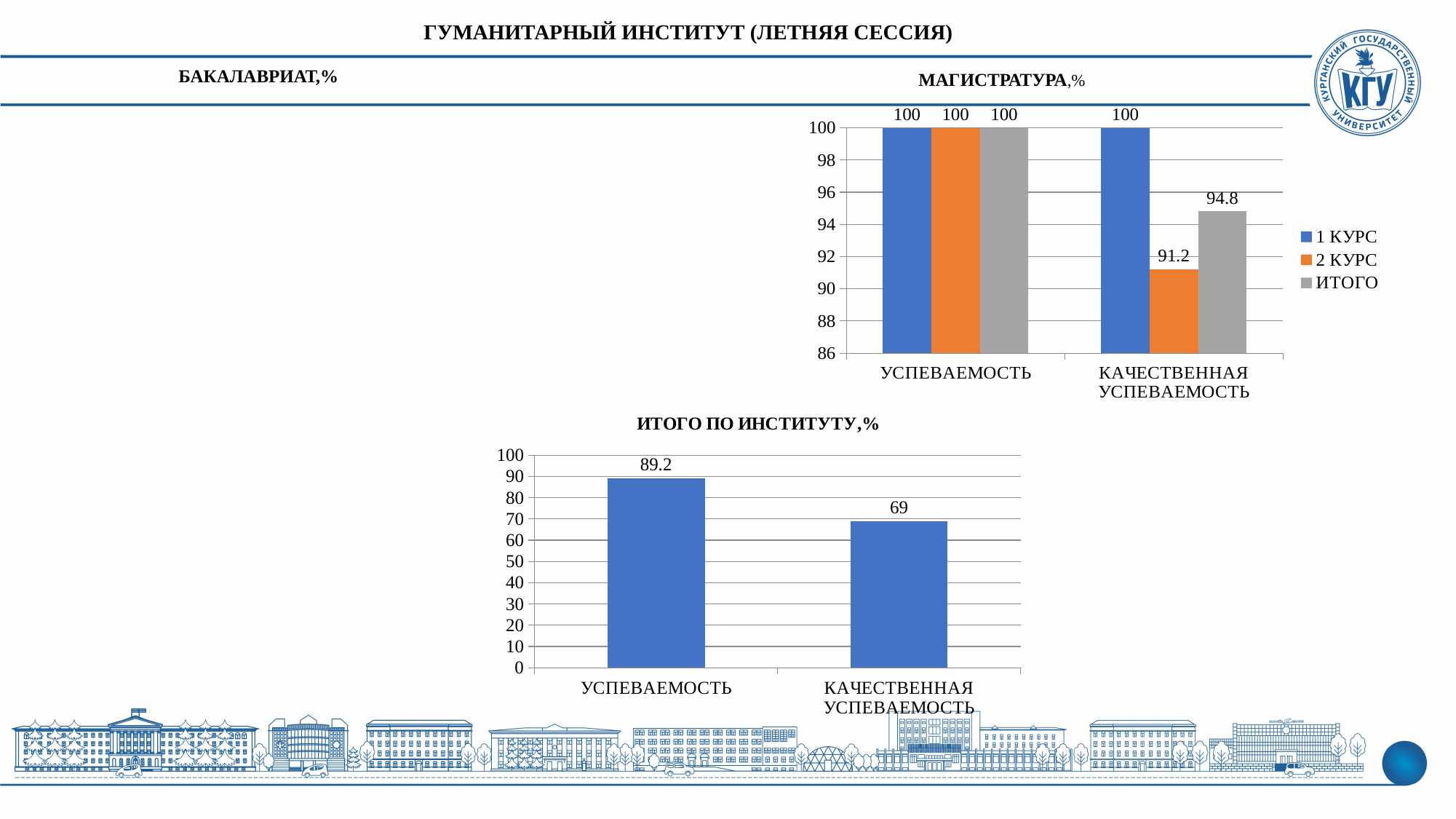
In the ИТОГО ПО ИНСТИТУТУ,% chart, what is the value for КАЧЕСТВЕННАЯ УСПЕВАЕМОСТЬ? 69 In the МАГИСТРАТУРА,% chart, how many series does the legend list? 3 In the МАГИСТРАТУРА,% chart, what is the value of ИТОГО for КАЧЕСТВЕННАЯ УСПЕВАЕМОСТЬ? 94.8 What kind of chart is the ИТОГО ПО ИНСТИТУТУ,% chart? Bar chart In the МАГИСТРАТУРА,% chart, what is the value of 1 КУРС for УСПЕВАЕМОСТЬ? 100 In the МАГИСТРАТУРА,% chart, which series has the lowest value for КАЧЕСТВЕННАЯ УСПЕВАЕМОСТЬ? 2 КУРС In the ИТОГО ПО ИНСТИТУТУ,% chart, which category has the higher value? УСПЕВАЕМОСТЬ In the МАГИСТРАТУРА,% chart, which colour represents the ИТОГО series? Grey In the МАГИСТРАТУРА,% chart, what is the value of 2 КУРС for КАЧЕСТВЕННАЯ УСПЕВАЕМОСТЬ? 91.2 In the МАГИСТРАТУРА,% chart, what is the difference between the ИТОГО and 2 КУРС values for КАЧЕСТВЕННАЯ УСПЕВАЕМОСТЬ? 3.6 In the ИТОГО ПО ИНСТИТУТУ,% chart, what is the difference between УСПЕВАЕМОСТЬ and КАЧЕСТВЕННАЯ УСПЕВАЕМОСТЬ? 20.2 In the ИТОГО ПО ИНСТИТУТУ,% chart, what is the value for УСПЕВАЕМОСТЬ? 89.2